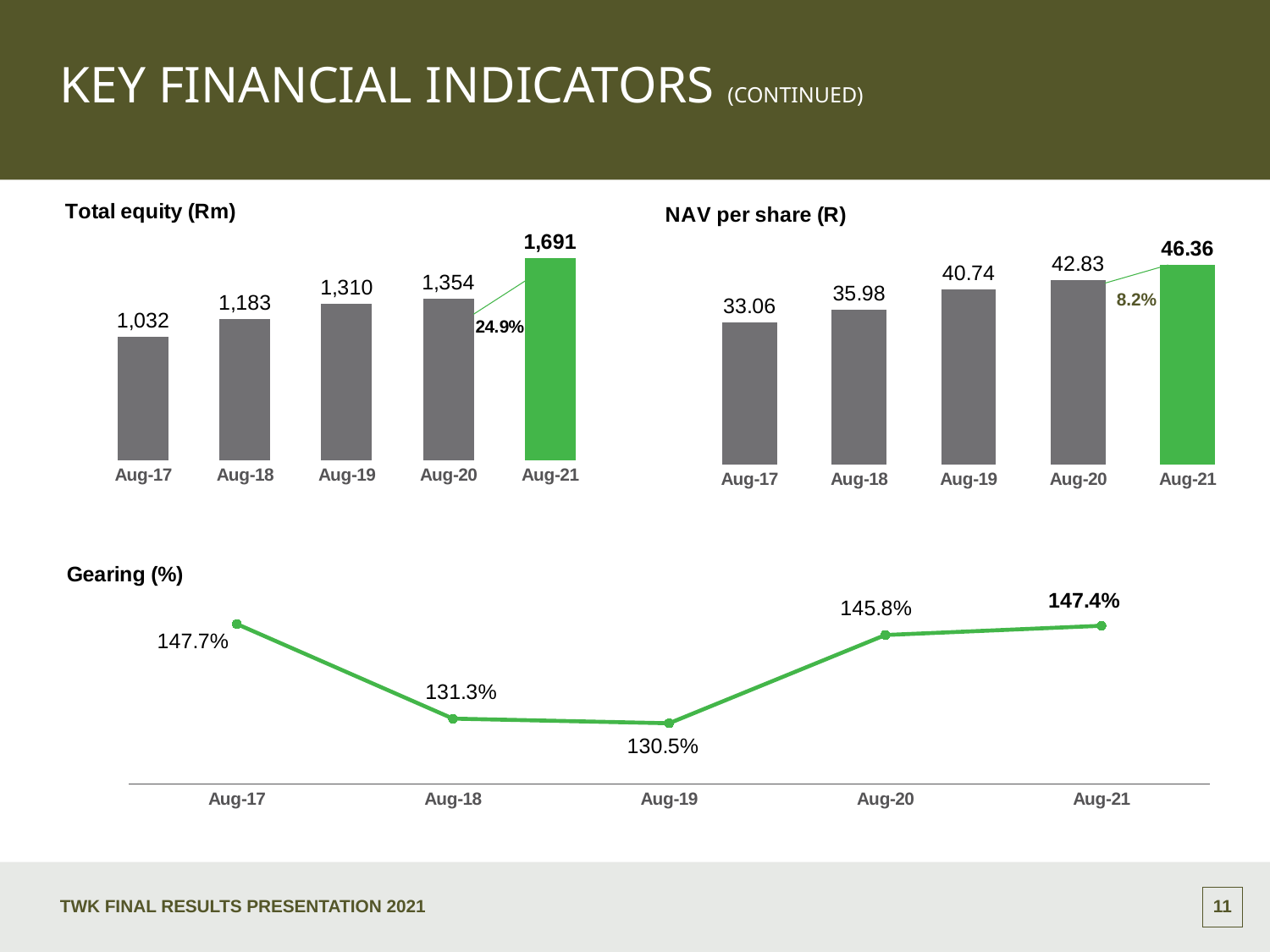
In the Total equity (Rm) chart, which year has the lowest value? Aug-17 In the Total equity (Rm) chart, what is the value for Aug-21? 1,691 In the NAV per share (R) chart, how many bars are plotted? 5 In the Total equity (Rm) chart, what is the difference between the Aug-21 and Aug-20 values? 337 What kind of chart is the Gearing (%) chart? line chart In the NAV per share (R) chart, which year has the highest value? Aug-21 In the Gearing (%) chart, what is the value for Aug-19? 130.5% In the NAV per share (R) chart, what is the value for Aug-19? 40.74 In the Gearing (%) chart, what is the difference between the Aug-20 and Aug-18 values? 14.5% In the Total equity (Rm) chart, what percentage change is shown between Aug-20 and Aug-21? 24.9% In the Gearing (%) chart, which is larger, the value for Aug-17 or the value for Aug-21? Aug-17 In the NAV per share (R) chart, do the values rise or fall from Aug-17 to Aug-21? rise